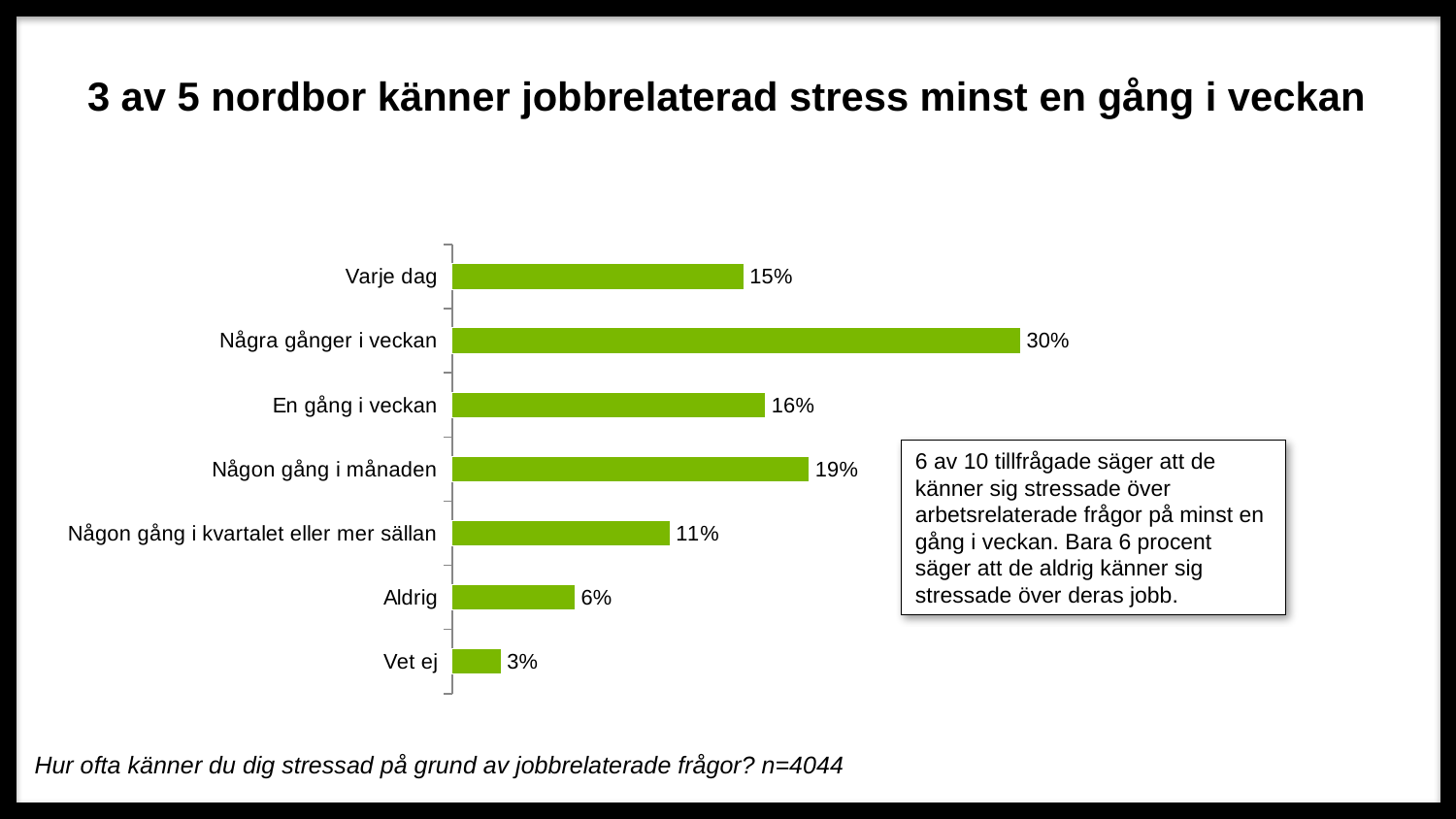
What is the value for "Någon gång i månaden"? 19% Which is larger, the value for "En gång i veckan" or the value for "Någon gång i kvartalet eller mer sällan"? En gång i veckan What colour are the bars in the chart? Green How many categories are shown in the chart? 7 Which category has the lowest value? Vet ej Which category has the highest value? Några gånger i veckan What is the combined value of "Varje dag", "Några gånger i veckan" and "En gång i veckan"? 61% What kind of chart is shown on the slide? Bar chart What is the value for "Aldrig"? 6% What is the value for "Några gånger i veckan"? 30% What is the difference between the values for "Några gånger i veckan" and "Varje dag"? 15% What is the sample size (n) stated below the chart? n=4044